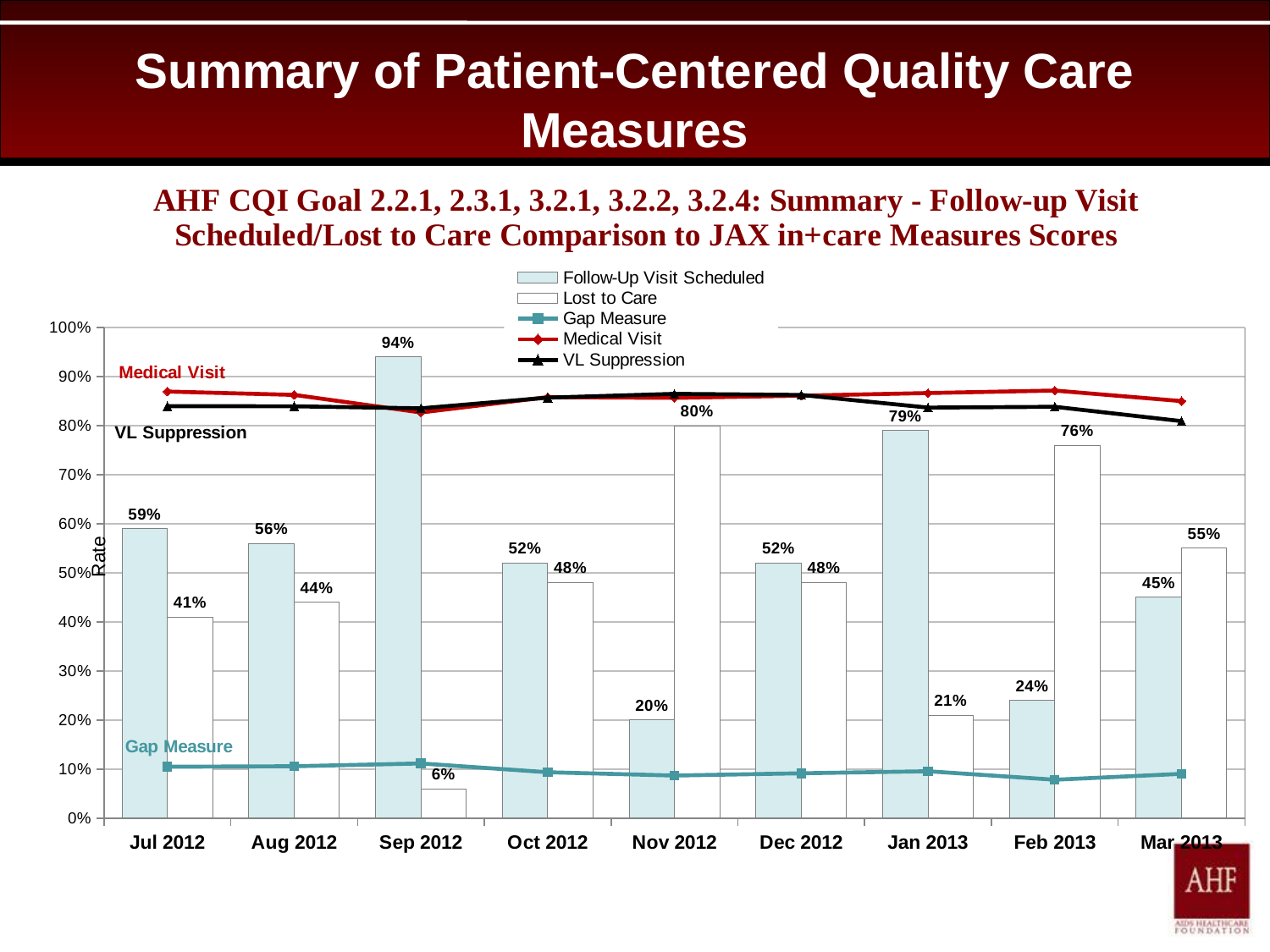
How many series does the legend list? 5 What is the difference between the Lost to Care and Follow-Up Visit Scheduled values in Nov 2012? 60% In which month is the Lost to Care value lowest? Sep 2012 In which month is the Follow-Up Visit Scheduled value highest? Sep 2012 What is the Follow-Up Visit Scheduled value for Sep 2012? 94% How many months are shown on the x axis? 9 What kind of chart is shown on the slide? Combination bar and line chart Is the Gap Measure value for Nov 2012 greater or less than 20%? less In Mar 2013, which is larger: Follow-Up Visit Scheduled or Lost to Care? Lost to Care Is the Medical Visit value for Jul 2012 greater or less than 80%? greater What is the Follow-Up Visit Scheduled value for Jan 2013? 79% What is the Lost to Care value for Nov 2012? 80%